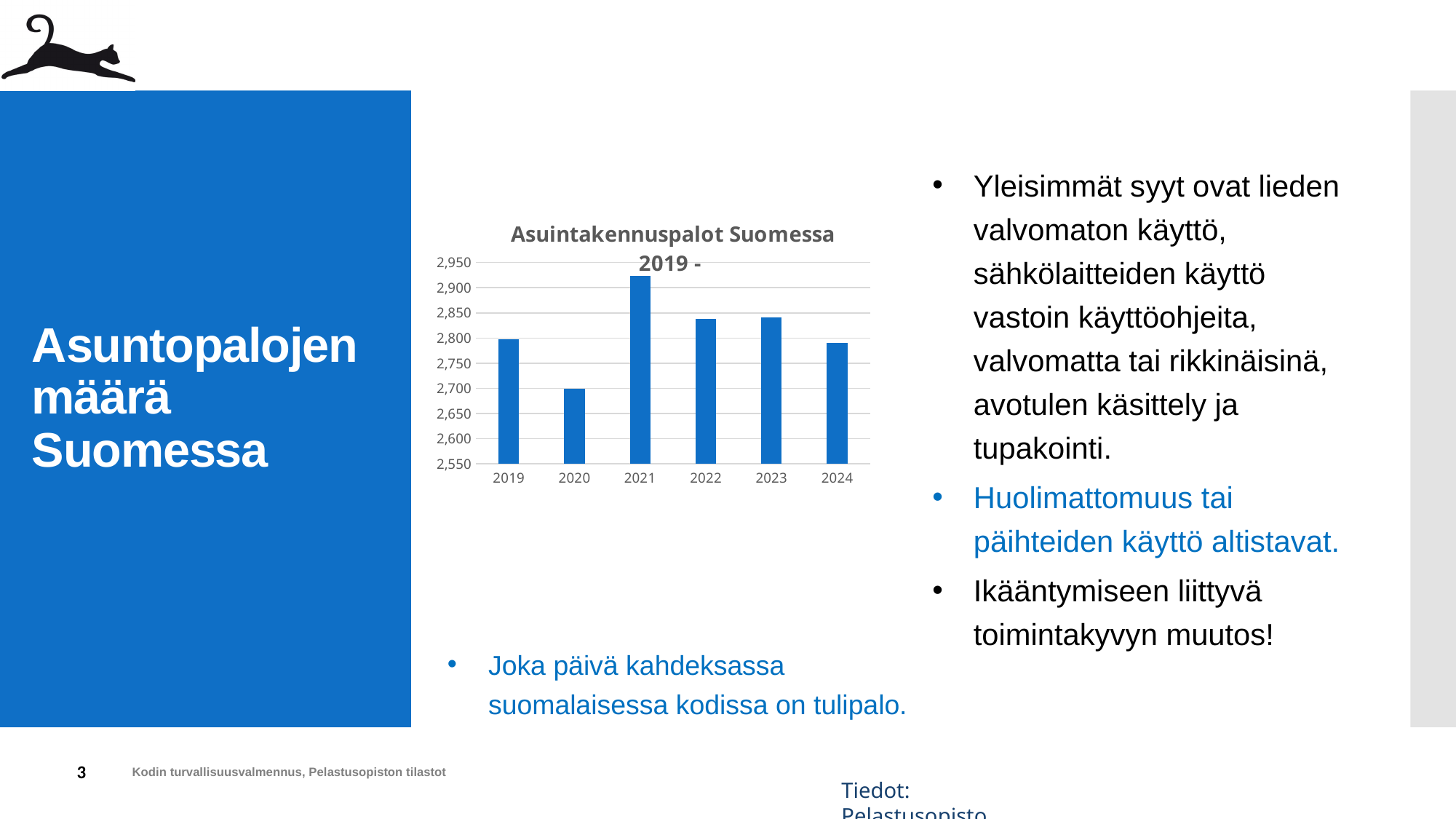
Which year has the larger value, 2021 or 2022? 2021 Which year has the larger value, 2019 or 2020? 2019 Which year has the highest bar in the chart? 2021 Does the value rise or fall from 2020 to 2021? rise Is the value for 2019 greater or less than 2,750? greater What kind of chart is shown on the slide? bar chart How many years are shown on the x axis of the chart? 6 Which year has the lowest bar in the chart? 2020 Is the value for 2020 greater or less than 2,750? less Is the value for 2022 greater or less than 2,800? greater What is the title of the chart? Asuintakennuspalot Suomessa 2019 -